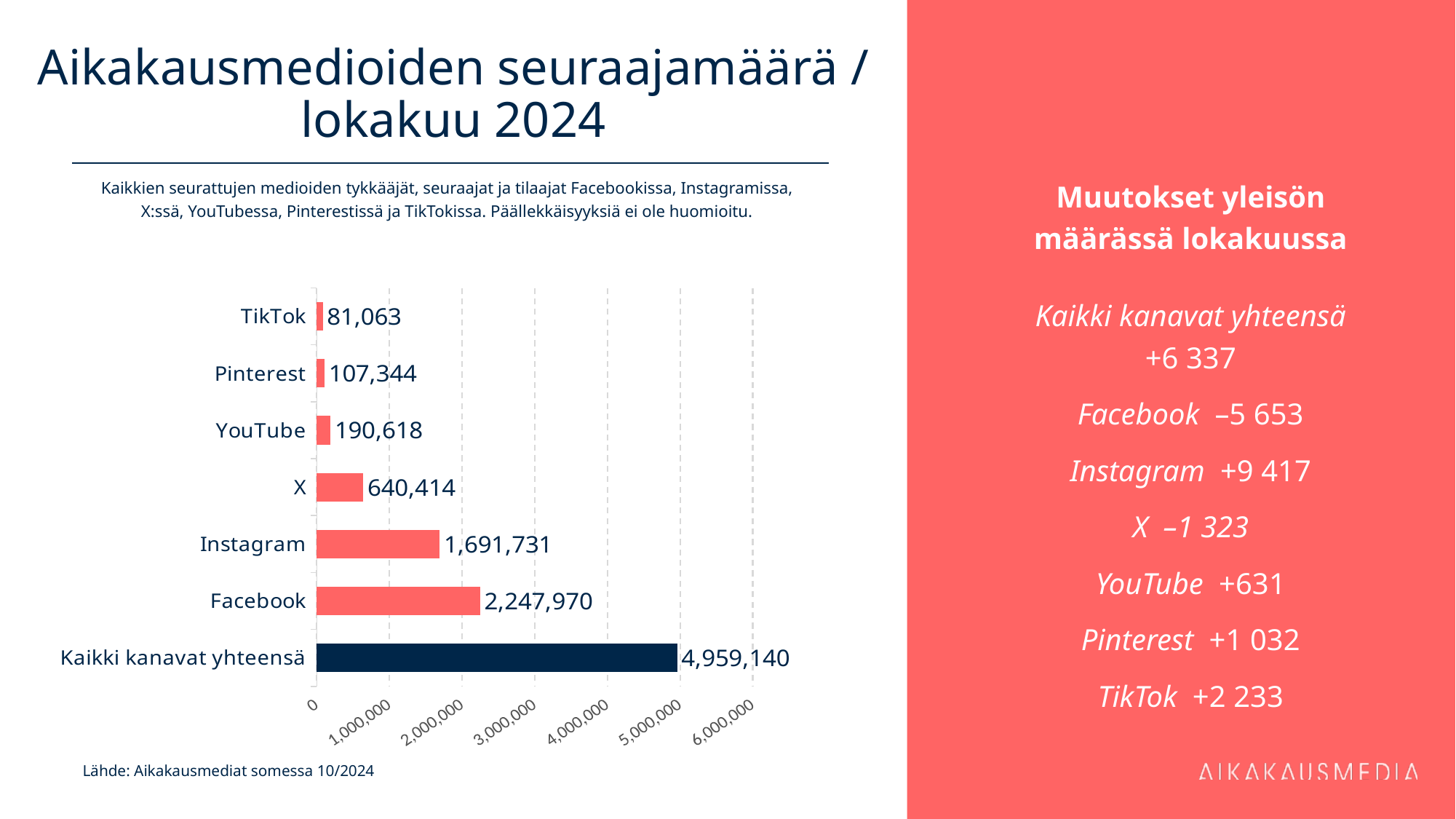
What is the value shown for TikTok? 81,063 How many categories are shown in the chart? 7 Which category has the lowest value in the chart? TikTok What is the difference between the values for X and YouTube? 449,796 Which is larger, the value for Pinterest or the value for YouTube? YouTube Which category has the highest value in the chart? Kaikki kanavat yhteensä What is the value shown for Facebook? 2,247,970 What kind of chart is shown on the slide? bar chart Is the value for X greater or less than 1,000,000? less What is the difference between the values for Facebook and Instagram? 556,239 What is the value shown for Instagram? 1,691,731 What is the value shown for Kaikki kanavat yhteensä? 4,959,140